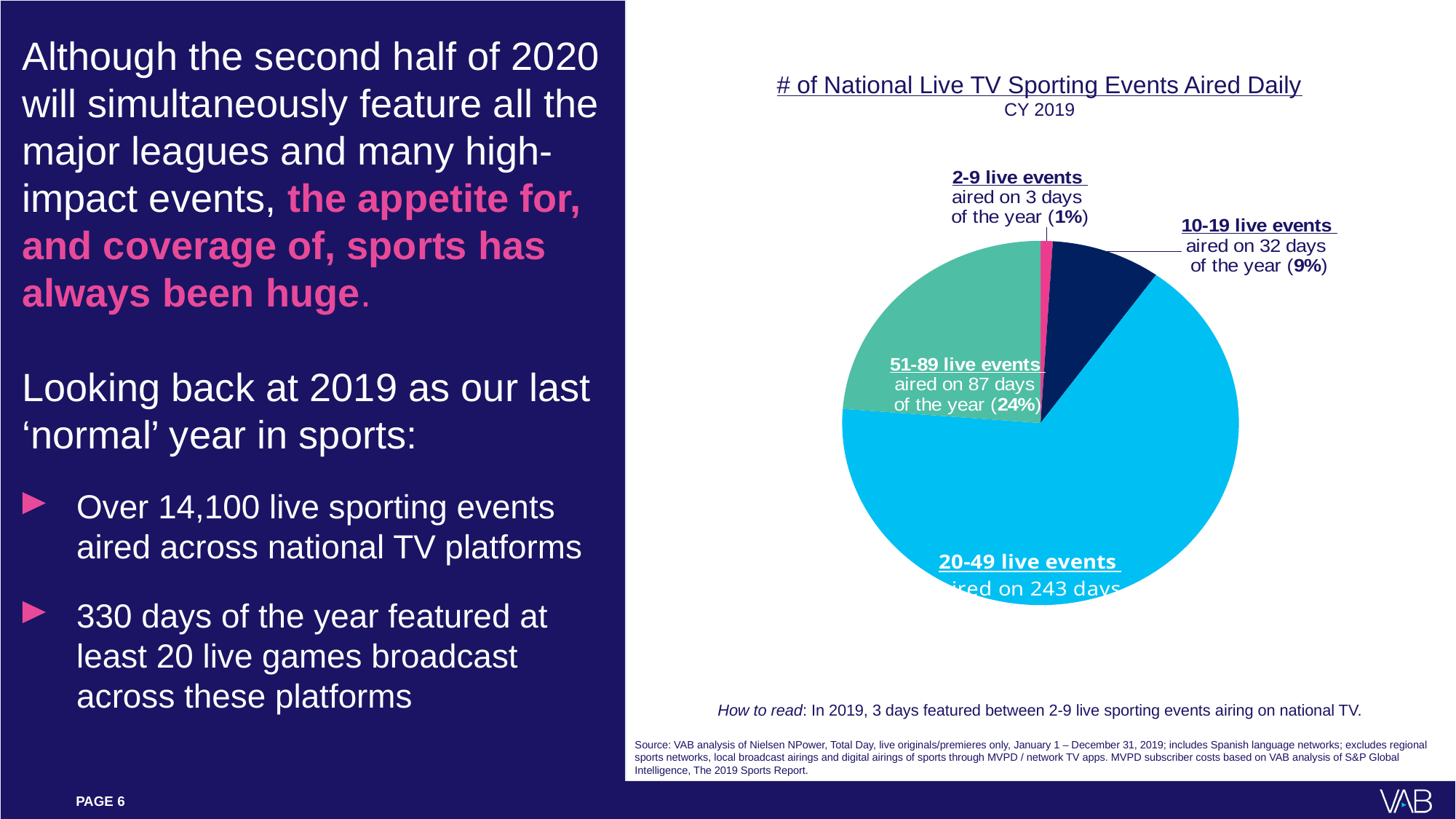
What share of the pie does the 51-89 live events slice represent? 24% Which category accounts for the largest slice of the pie? 20-49 live events On how many days of the year were 51-89 live events aired? 87 days What is the title of the pie chart? # of National Live TV Sporting Events Aired Daily How many more days featured 51-89 live events than 10-19 live events? 55 days What share of the pie does the 10-19 live events slice represent? 9% What share of the pie does the 2-9 live events slice represent? 1% On how many days of the year were 10-19 live events aired? 32 days What kind of chart is shown on the slide? Pie chart Which category accounts for the smallest slice of the pie? 2-9 live events On how many days of the year were 20-49 live events aired? 243 days How many slices does the pie chart have? 4